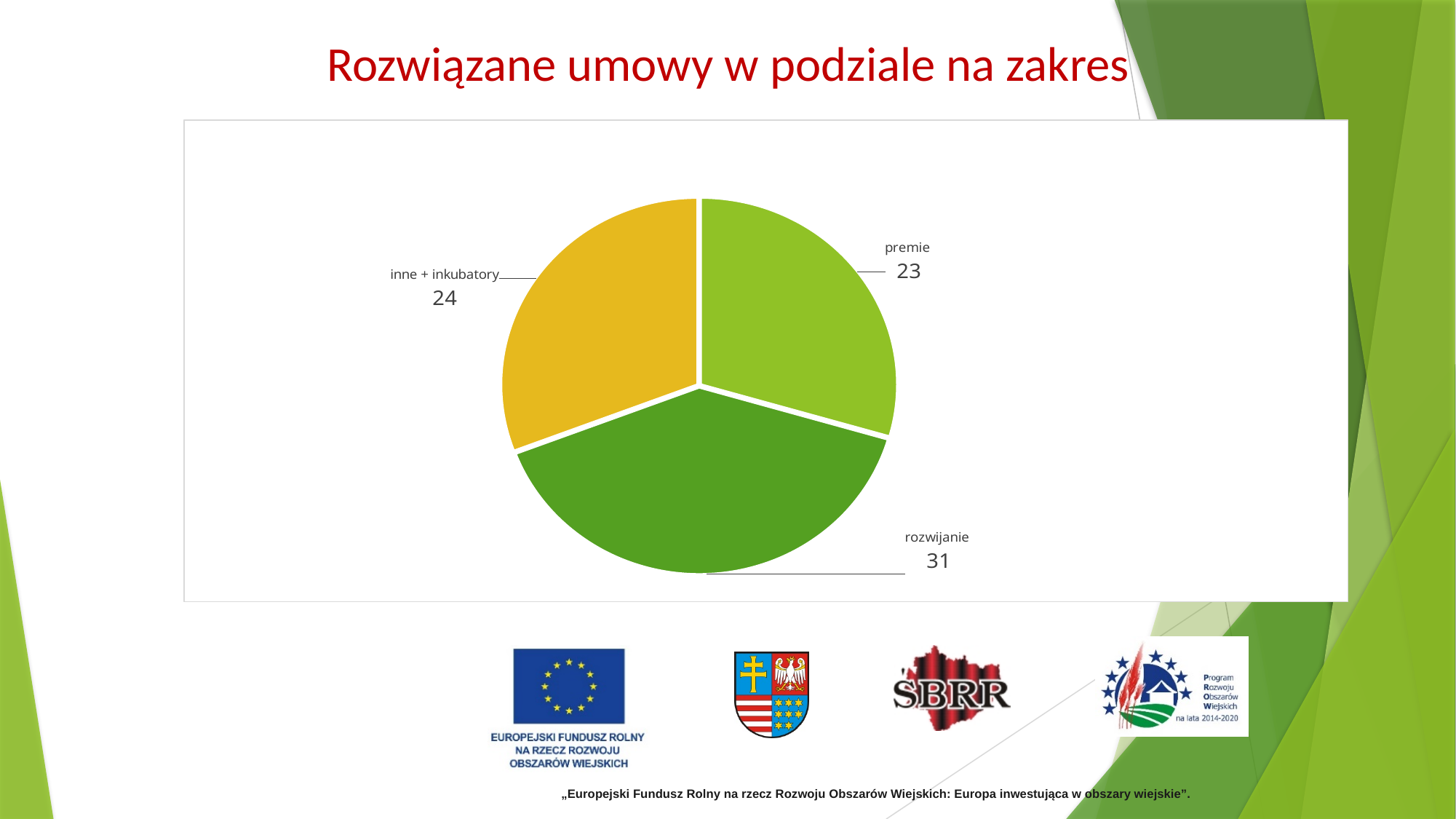
What is the value for the "rozwijanie" slice? 31 What is the value for the "inne + inkubatory" slice? 24 What is the difference between the values for "rozwijanie" and "premie"? 8 What type of chart is shown on the slide? pie chart How many slices does the pie chart have? 3 What is the value for the "premie" slice? 23 Which category has the largest slice of the pie? rozwijanie What is the difference between the values for "inne + inkubatory" and "premie"? 1 Which is larger, the value for "inne + inkubatory" or the value for "premie"? inne + inkubatory What is the title of the slide containing the pie chart? Rozwiązane umowy w podziale na zakres What is the total of all the slice values in the pie chart? 78 Which category has the smallest slice of the pie? premie